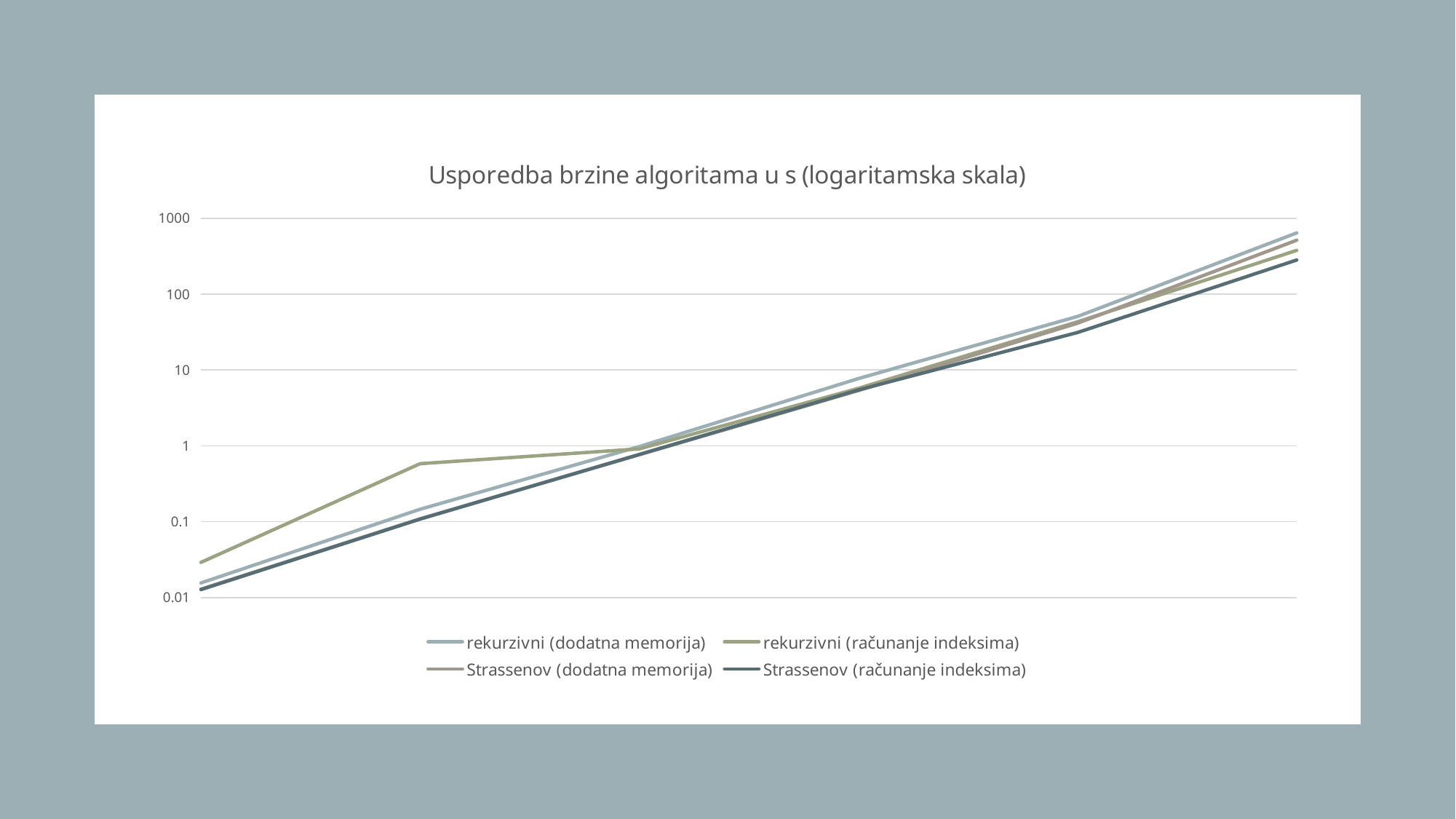
How many series does the legend list? 4 Is the rightmost value for rekurzivni (dodatna memorija) greater or less than 100? greater What kind of chart is shown on the slide? line chart Do the values of the series rise or fall from left to right along the x axis? rise Is the leftmost value for Strassenov (računanje indeksima) greater or less than 0.1? less At the rightmost point, which is larger: the value for Strassenov (dodatna memorija) or the value for Strassenov (računanje indeksima)? Strassenov (dodatna memorija) Which series has the lowest value at the rightmost point of the chart? Strassenov (računanje indeksima) What is the highest value labelled on the vertical axis? 1000 Which series has the highest value at the leftmost point of the chart? rekurzivni (računanje indeksima) Which series has the highest value at the rightmost point of the chart? rekurzivni (dodatna memorija) At the leftmost point, which is larger: the value for rekurzivni (računanje indeksima) or the value for rekurzivni (dodatna memorija)? rekurzivni (računanje indeksima) What is the title of the chart? Usporedba brzine algoritama u s (logaritamska skala)